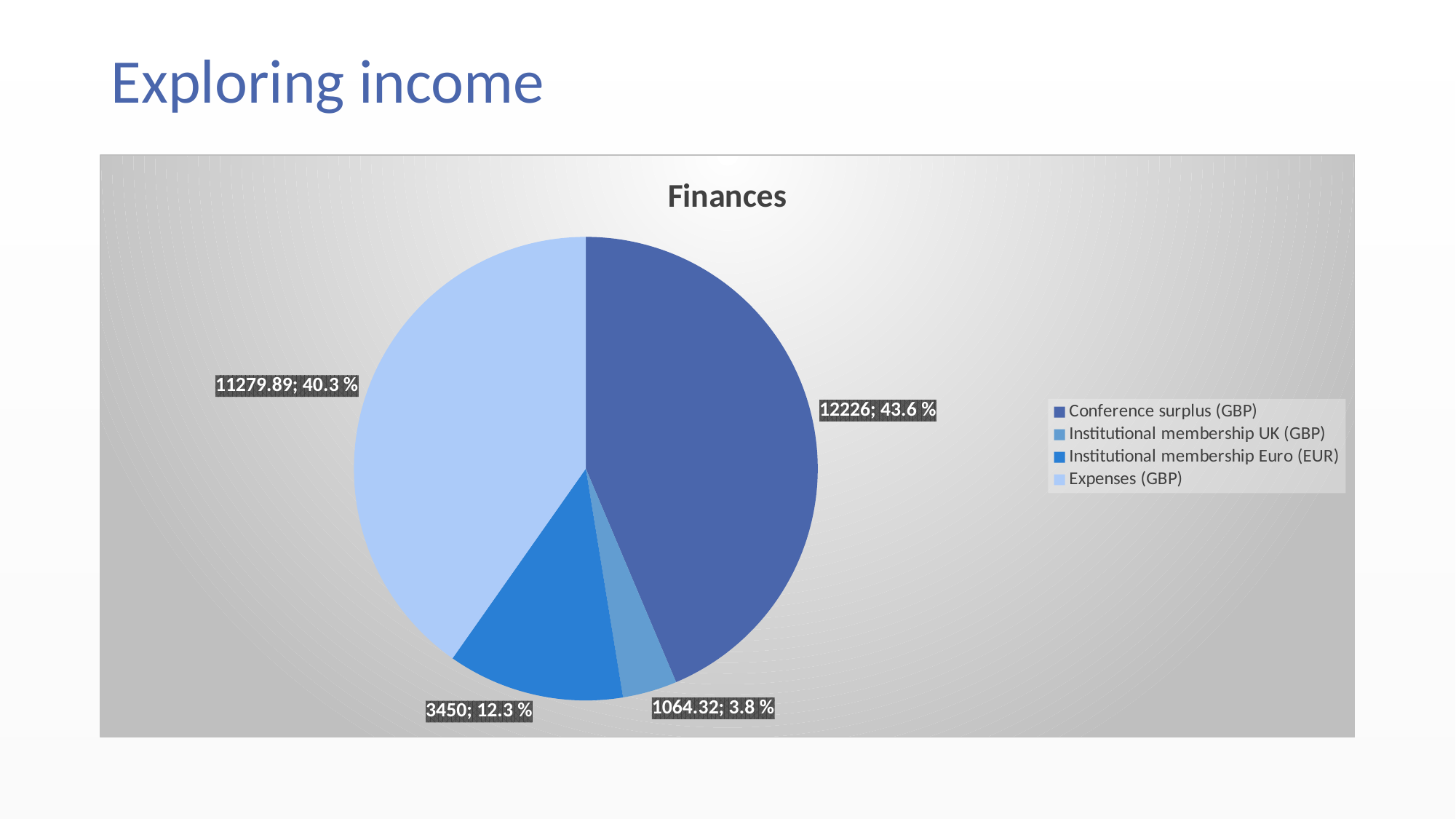
Which is larger, the value for Institutional membership Euro (EUR) or the value for Institutional membership UK (GBP)? Institutional membership Euro (EUR) How many slices does the pie chart have? 4 Which category has the smallest slice of the pie? Institutional membership UK (GBP) Which category has the largest slice of the pie? Conference surplus (GBP) What share of the pie does Conference surplus (GBP) represent? 43.6 % What is the title of the chart? Finances What is the value shown for Institutional membership Euro (EUR)? 3450 What kind of chart is shown on the slide? Pie chart What is the value shown for Institutional membership UK (GBP)? 1064.32 What share of the pie does Institutional membership UK (GBP) represent? 3.8 % What is the value shown for Expenses (GBP)? 11279.89 What is the value shown for Conference surplus (GBP)? 12226